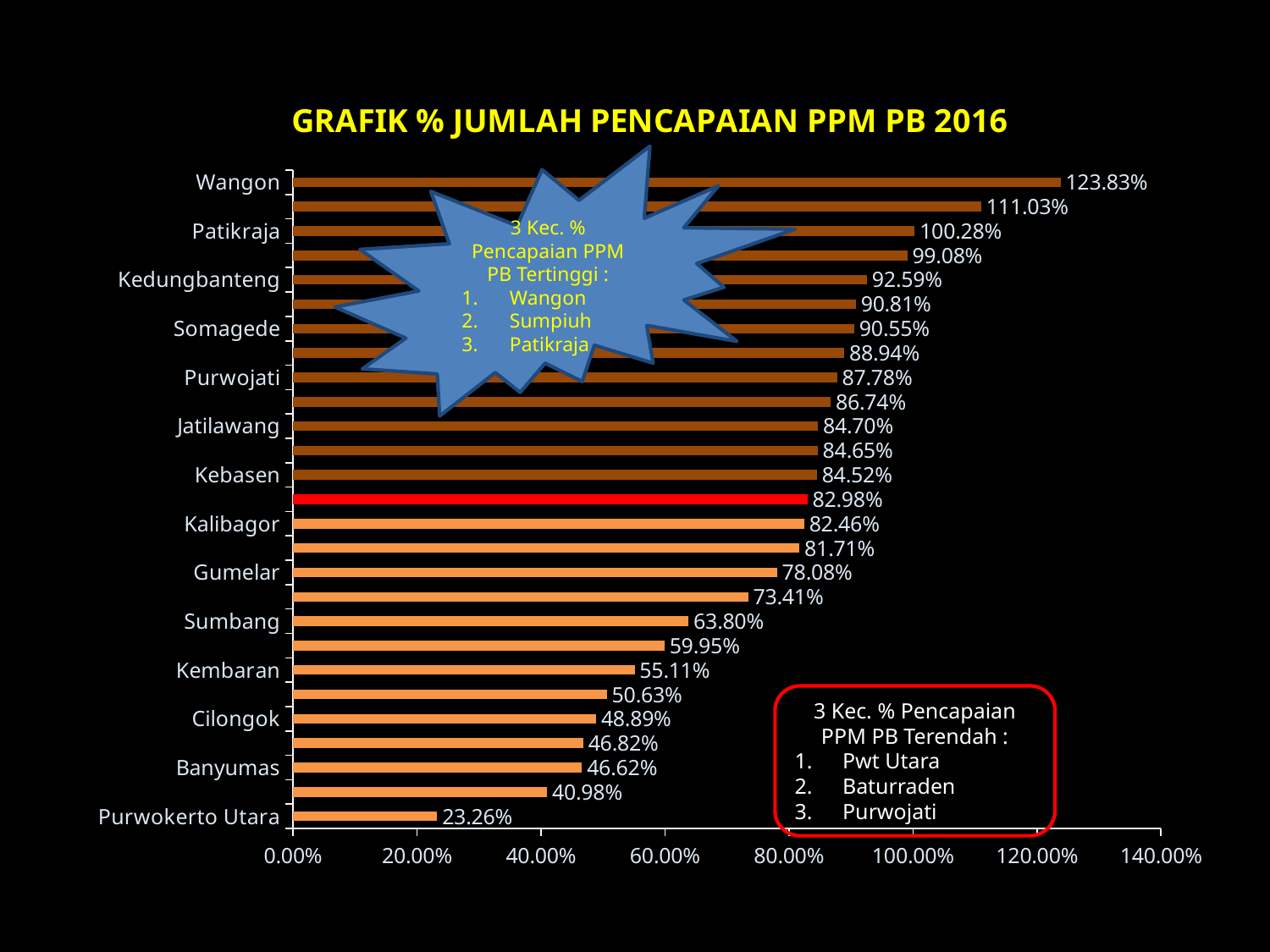
What is the value for Sumbang? 63.80% What kind of chart is shown on the slide? bar chart What is the difference between the values for Wangon and Purwokerto Utara? 100.57% Which has a larger value, Kalibagor or Gumelar? Kalibagor Which category has the highest value in the chart? Wangon What is the value for Purwokerto Utara? 23.26% What is the value for Patikraja? 100.28% What is the value for Kedungbanteng? 92.59% Which category has the lowest value in the chart? Purwokerto Utara Is the value for Kembaran greater or less than 60.00%? less What is the title of the chart? GRAFIK % JUMLAH PENCAPAIAN PPM PB 2016 What is the value for Wangon? 123.83%